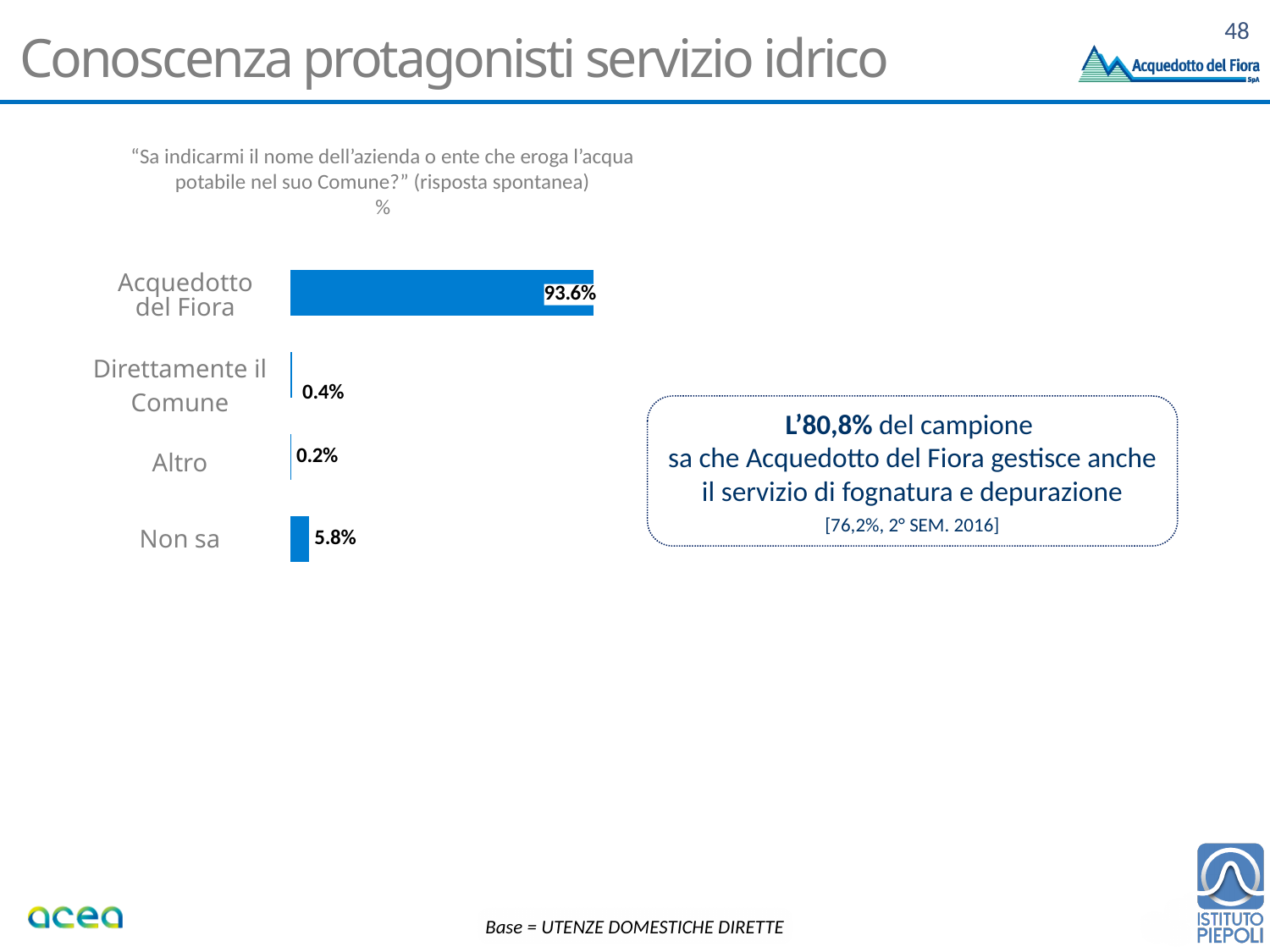
What is the difference between the values for Direttamente il Comune and Altro? 0.2% What is the value for Direttamente il Comune? 0.4% Which is larger, the value for Non sa or the value for Direttamente il Comune? Non sa What is the value for Non sa? 5.8% How many categories does the chart show? 4 What kind of chart is shown on the slide? Bar chart What is the title of the slide? Conoscenza protagonisti servizio idrico What is the value for Acquedotto del Fiora? 93.6% Which category has the highest value? Acquedotto del Fiora What is the difference between the values for Acquedotto del Fiora and Non sa? 87.8% What is the value for Altro? 0.2% Which category has the lowest value? Altro